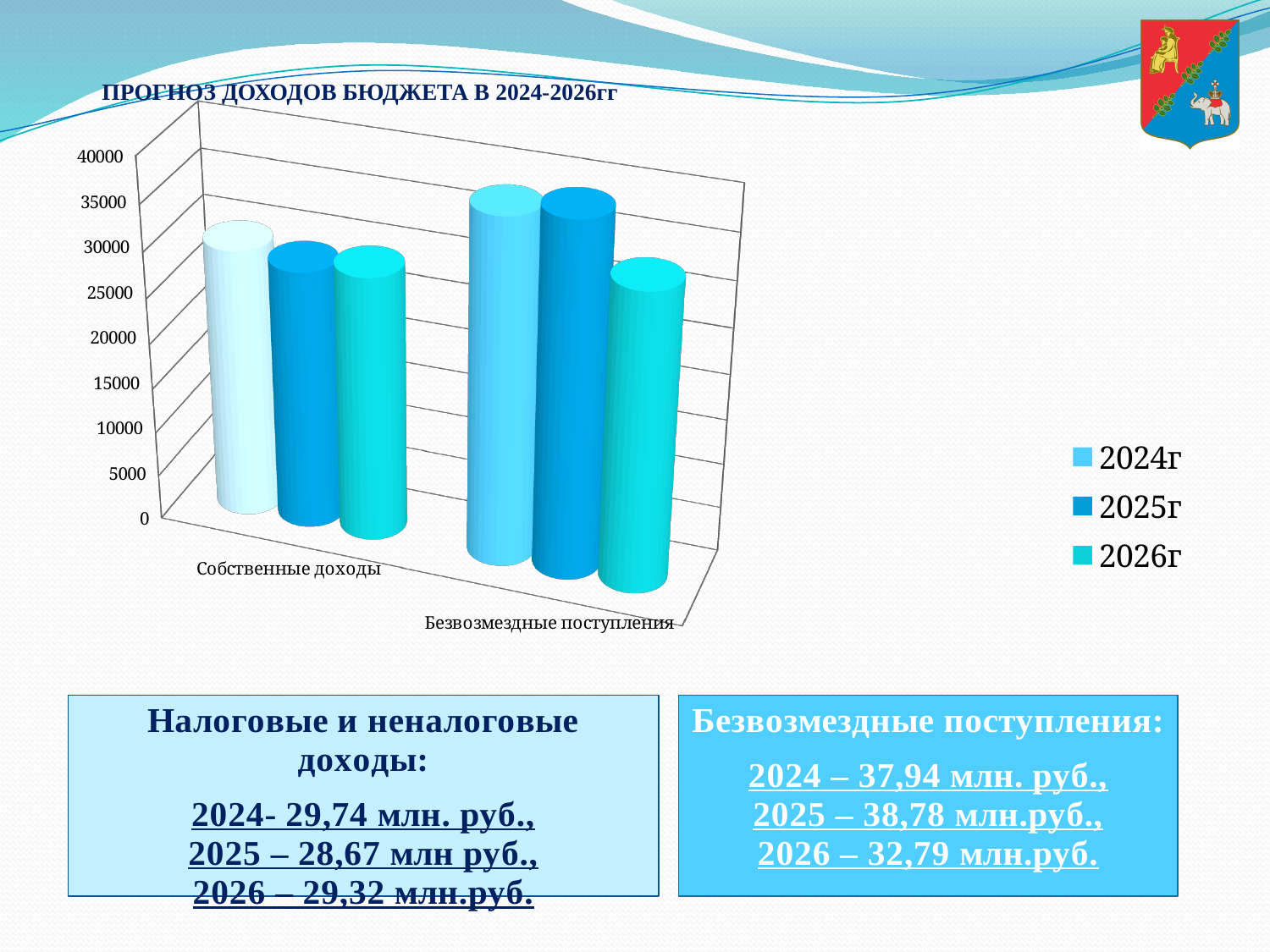
What are the three entries in the chart legend? 2024г, 2025г, 2026г What type of chart is shown on the slide? bar chart Which year has the lowest value for Безвозмездные поступления? 2026г Which category has the larger value for 2024г: Собственные доходы or Безвозмездные поступления? Безвозмездные поступления Is the value for Безвозмездные поступления in 2025г greater or less than 35000? greater How many series does the chart legend list? 3 How many categories are shown on the x axis of the chart? 2 Is the value for Собственные доходы in 2024г greater or less than 25000? greater For Безвозмездные поступления, which is larger: the 2025г value or the 2026г value? 2025г What is the title of the chart? ПРОГНОЗ ДОХОДОВ БЮДЖЕТА В 2024-2026гг